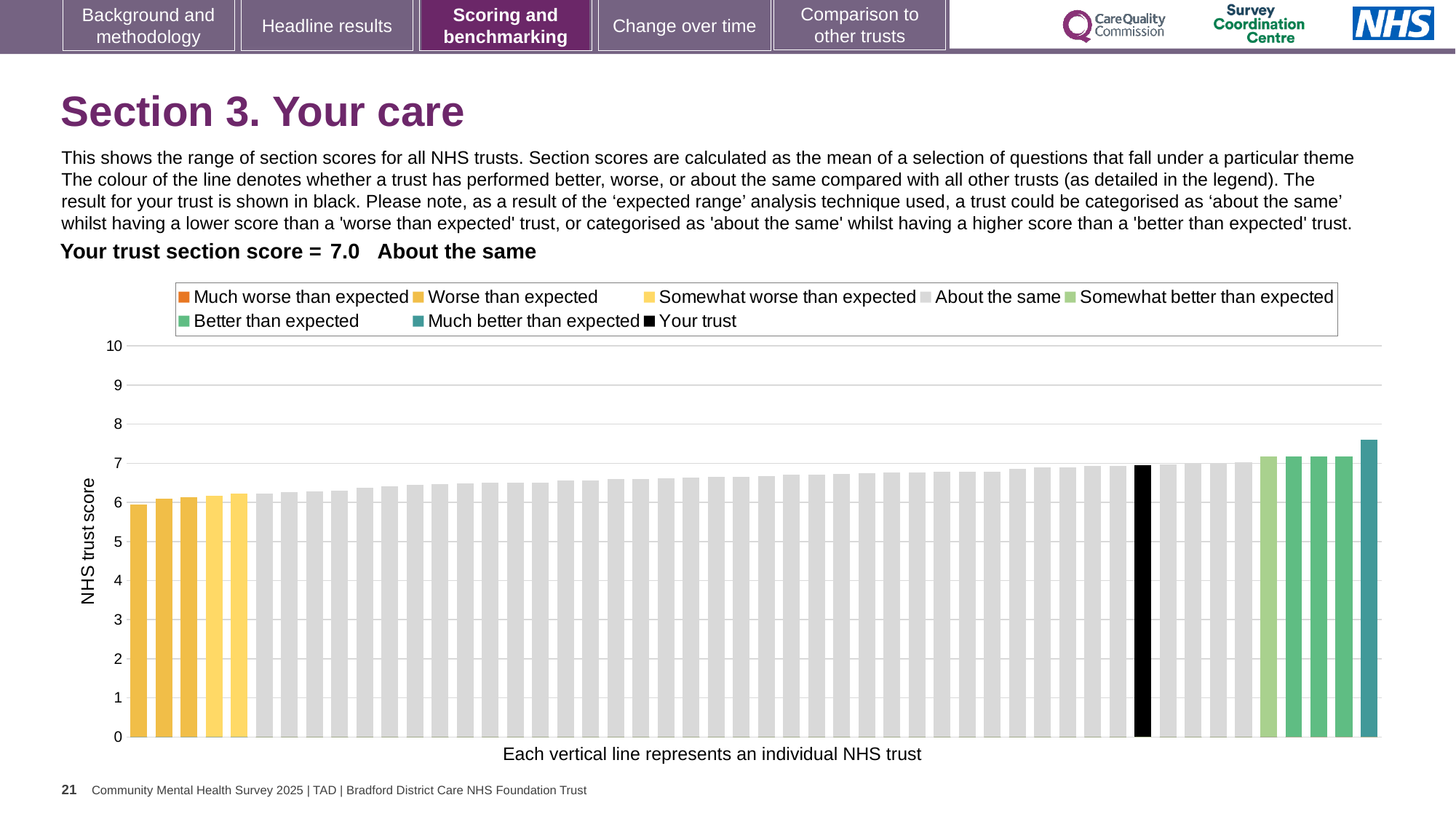
Do the bar values rise or fall moving from left to right along the x axis? rise Is the value of the black 'Your trust' bar greater or less than 5? greater What is the label on the vertical axis of the chart? NHS trust score How many entries does the chart legend list? 8 What is the section score for your trust shown on the slide? 7.0 Is the value of the tallest bar (the teal bar at the far right) greater or less than 7? greater How many bars are coloured teal (Much better than expected)? 1 Is the black 'Your trust' bar higher or lower than the teal bar at the far right? lower Which legend category does the highest bar on the chart belong to? Much better than expected Which performance category is your trust placed in for Section 3? About the same Is the value of the shortest bar (the first bar on the left) greater or less than 7? less What kind of chart is shown on the slide? Bar chart